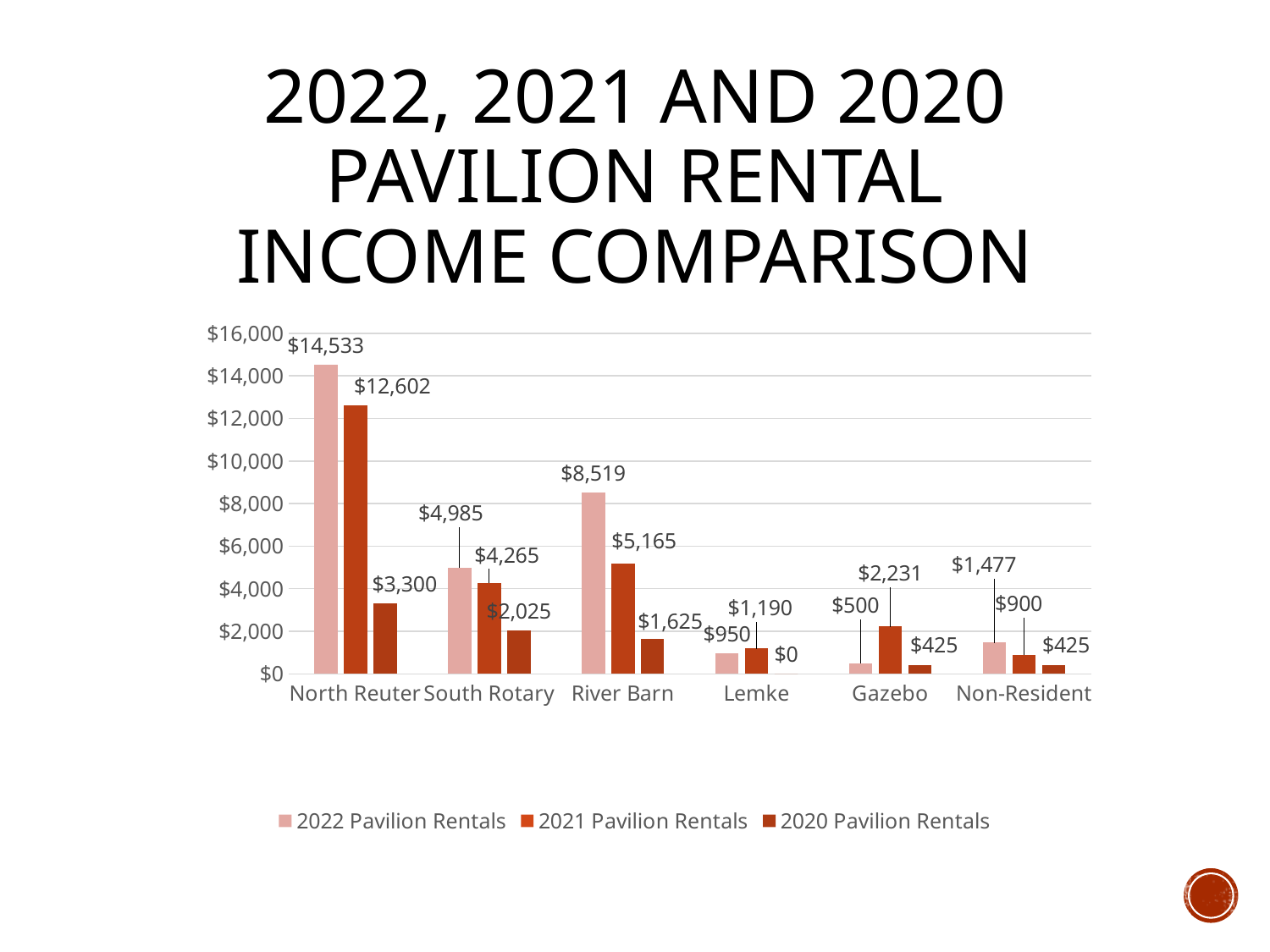
What is the title of the slide containing the chart? 2022, 2021 AND 2020 PAVILION RENTAL INCOME COMPARISON What type of chart is shown on the slide? Bar chart How many series does the chart legend list? 3 How many categories are shown on the x axis of the chart? 6 What was the 2022 Pavilion Rentals income for North Reuter? $14,533 Which is larger for Lemke: the 2022 Pavilion Rentals income or the 2021 Pavilion Rentals income? 2021 Pavilion Rentals What was the 2020 Pavilion Rentals income for River Barn? $1,625 What is the total of the 2020 Pavilion Rentals income for Gazebo and Non-Resident? $850 Which category had the lowest 2020 Pavilion Rentals income? Lemke What is the difference between the 2022 and 2021 Pavilion Rentals income for River Barn? $3,354 What was the 2021 Pavilion Rentals income for Gazebo? $2,231 Which category had the highest 2022 Pavilion Rentals income? North Reuter